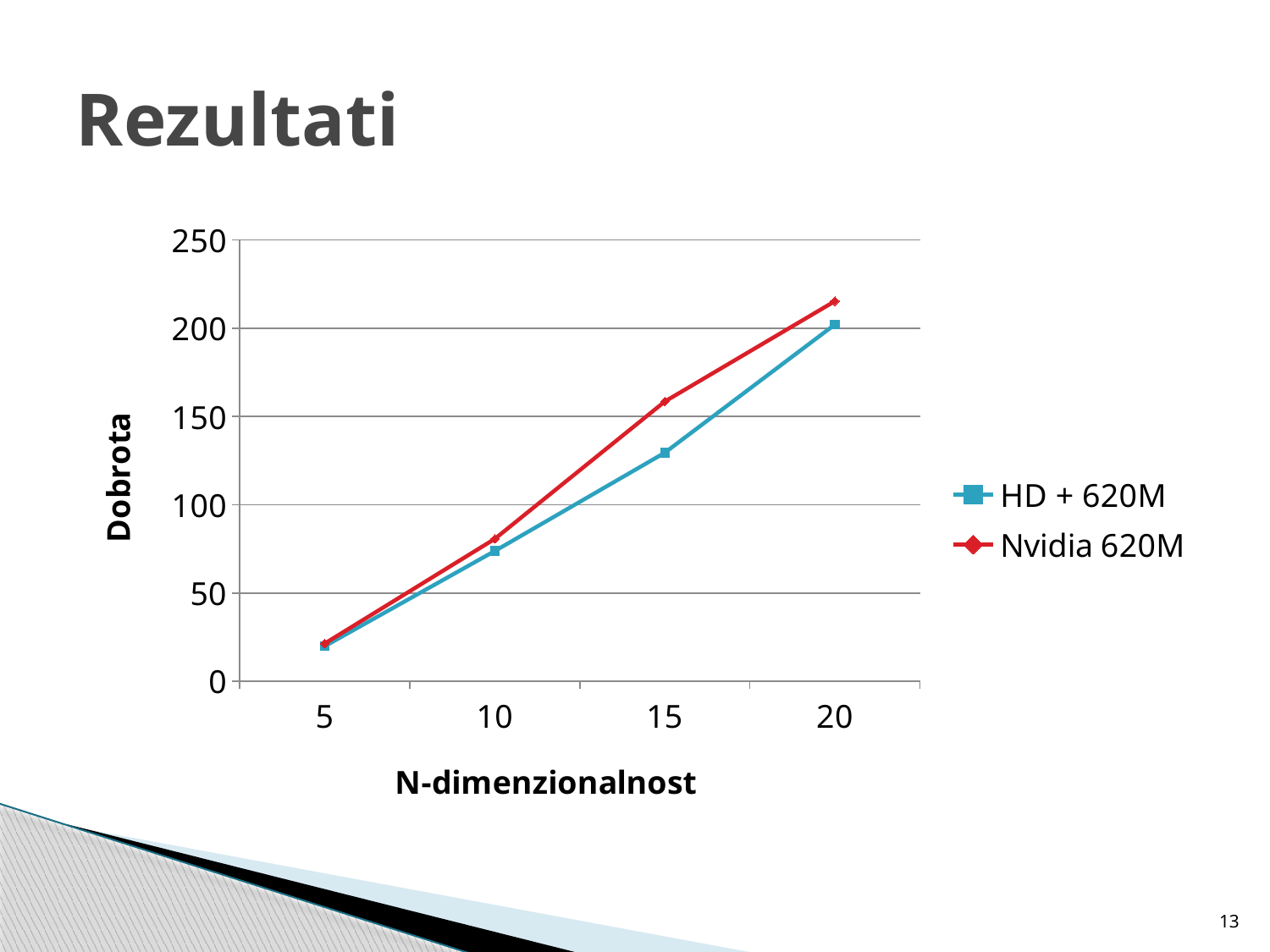
What kind of chart is shown on the slide? line chart At which N-dimenzionalnost value does HD + 620M have its lowest Dobrota? 5 Is the value for HD + 620M at N-dimenzionalnost 10 greater or less than 100? less What is the title of the vertical axis? Dobrota Is the value for Nvidia 620M at N-dimenzionalnost 20 greater or less than 200? greater At which N-dimenzionalnost value does Nvidia 620M reach its highest Dobrota? 20 Do the values for HD + 620M rise or fall as N-dimenzionalnost increases? rise Is the value for HD + 620M at N-dimenzionalnost 15 greater or less than 150? less How many points are plotted along the x axis for each series? 4 How many series does the legend list? 2 At N-dimenzionalnost 15, which series has the higher value, HD + 620M or Nvidia 620M? Nvidia 620M Do the values for Nvidia 620M rise or fall as N-dimenzionalnost increases? rise